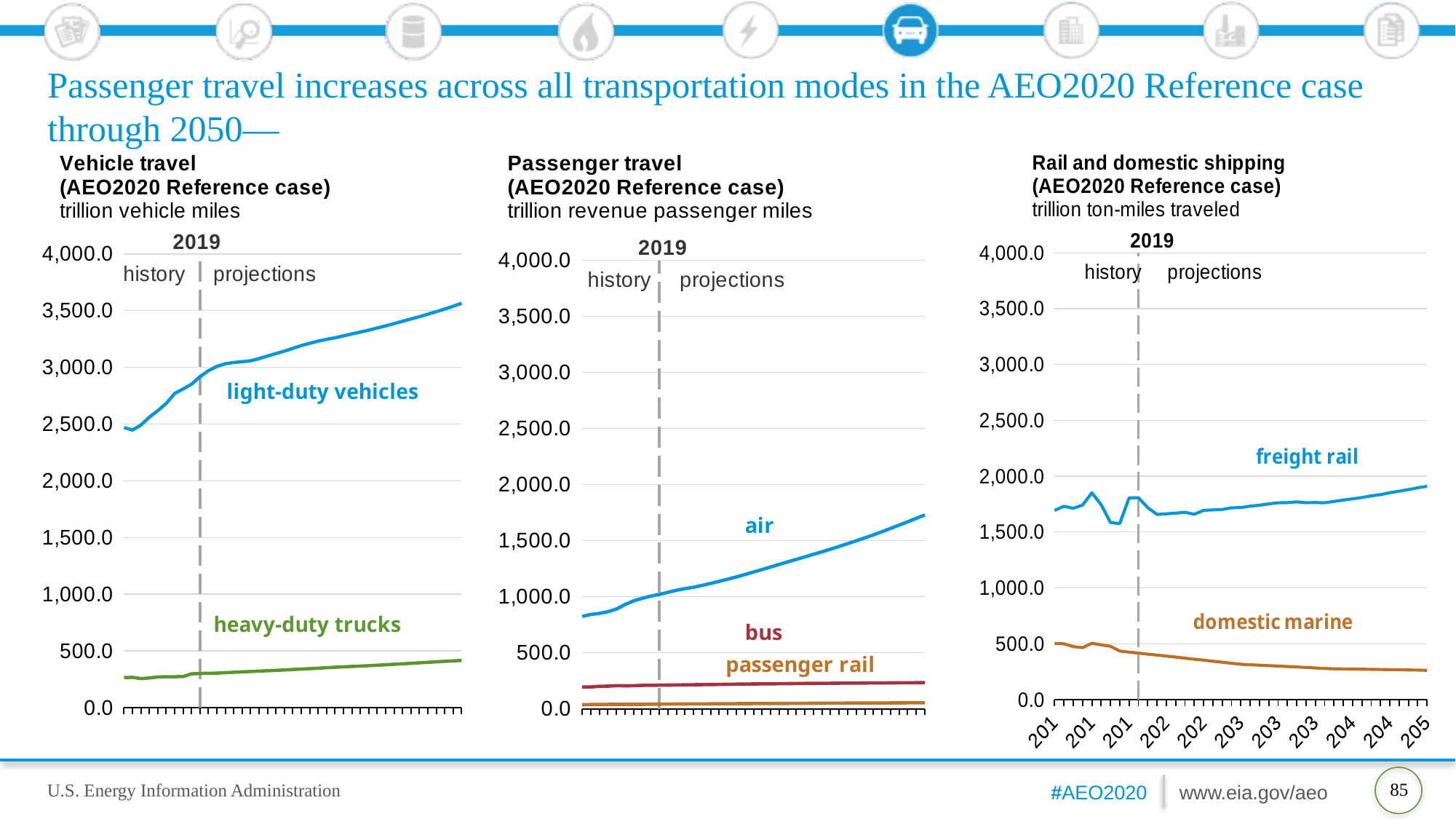
On the Passenger travel chart, is the value for air at the end of the projection greater or less than 1,500.0? greater What unit is used on the Rail and domestic shipping chart? trillion ton-miles traveled On the Rail and domestic shipping chart, does domestic marine rise or fall over the projection period? fall On the Vehicle travel chart, do light-duty vehicle miles rise or fall over the projection period? rise On the Passenger travel chart, which series has the lowest values? passenger rail On the Passenger travel chart, which series has the highest values? air On the Vehicle travel chart, which series has the higher values, light-duty vehicles or heavy-duty trucks? light-duty vehicles On the Rail and domestic shipping chart, is the value for freight rail at the end of the projection greater or less than 2,000.0? less How many series are plotted on the Rail and domestic shipping chart? 2 What kind of chart is the Vehicle travel chart? line chart How many series are plotted on the Passenger travel chart? 3 On the Vehicle travel chart, is the value for heavy-duty trucks at the end of the projection greater or less than 500.0? less